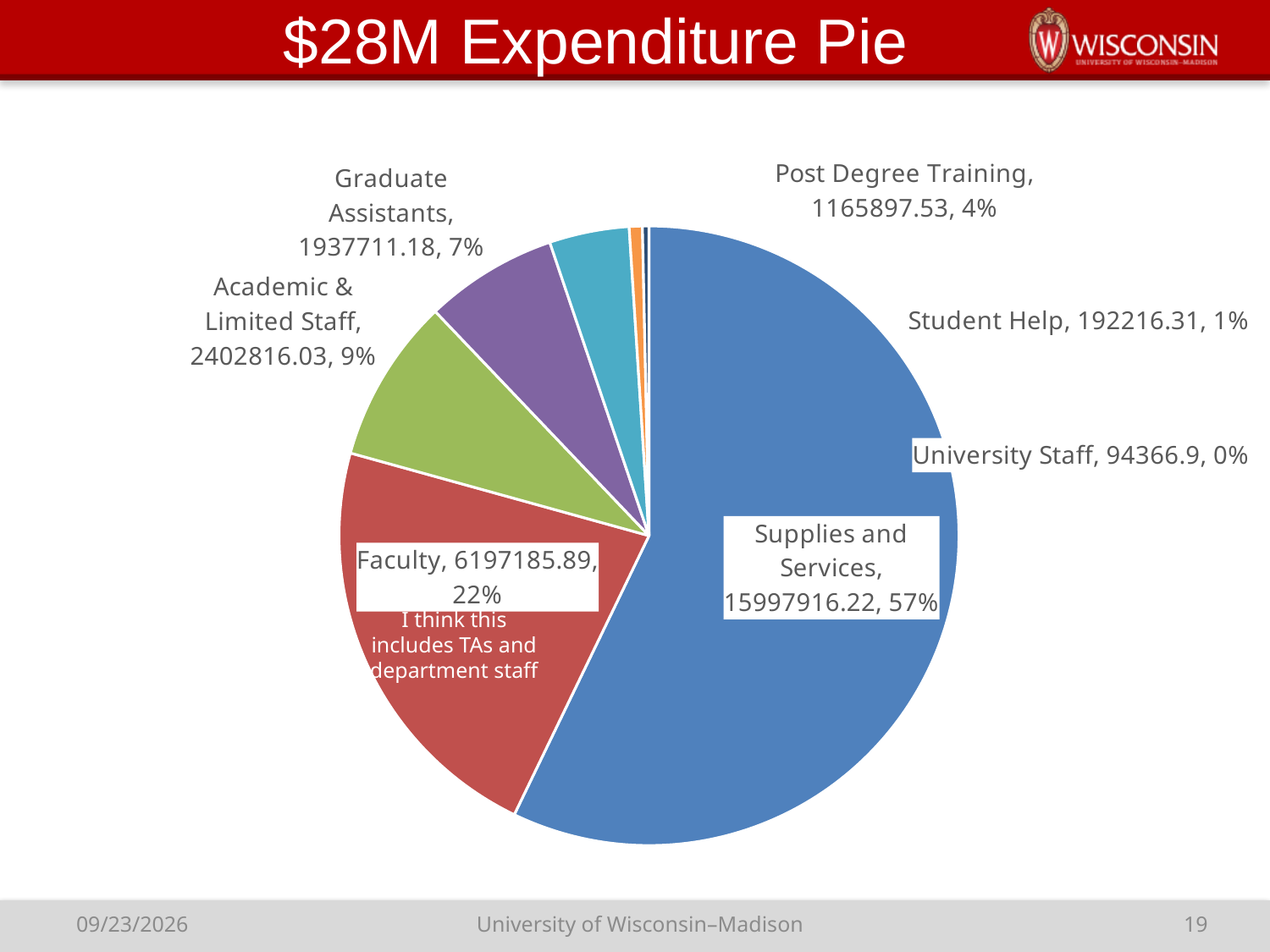
What share of the pie does Faculty represent? 22% What is the value for Academic & Limited Staff? 2402816.03 Which category has the largest slice of the pie? Supplies and Services What kind of chart is shown on the slide? pie chart What is the value for Student Help? 192216.31 What is the value for Supplies and Services? 15997916.22 What share of the pie does Graduate Assistants represent? 7% What is the title of the chart on the slide? $28M Expenditure Pie How many slices does the pie chart have? 7 Which category has the smallest slice of the pie? University Staff Which is larger, Post Degree Training or Student Help? Post Degree Training What is the difference between the Faculty value and the Academic & Limited Staff value? 3794369.86